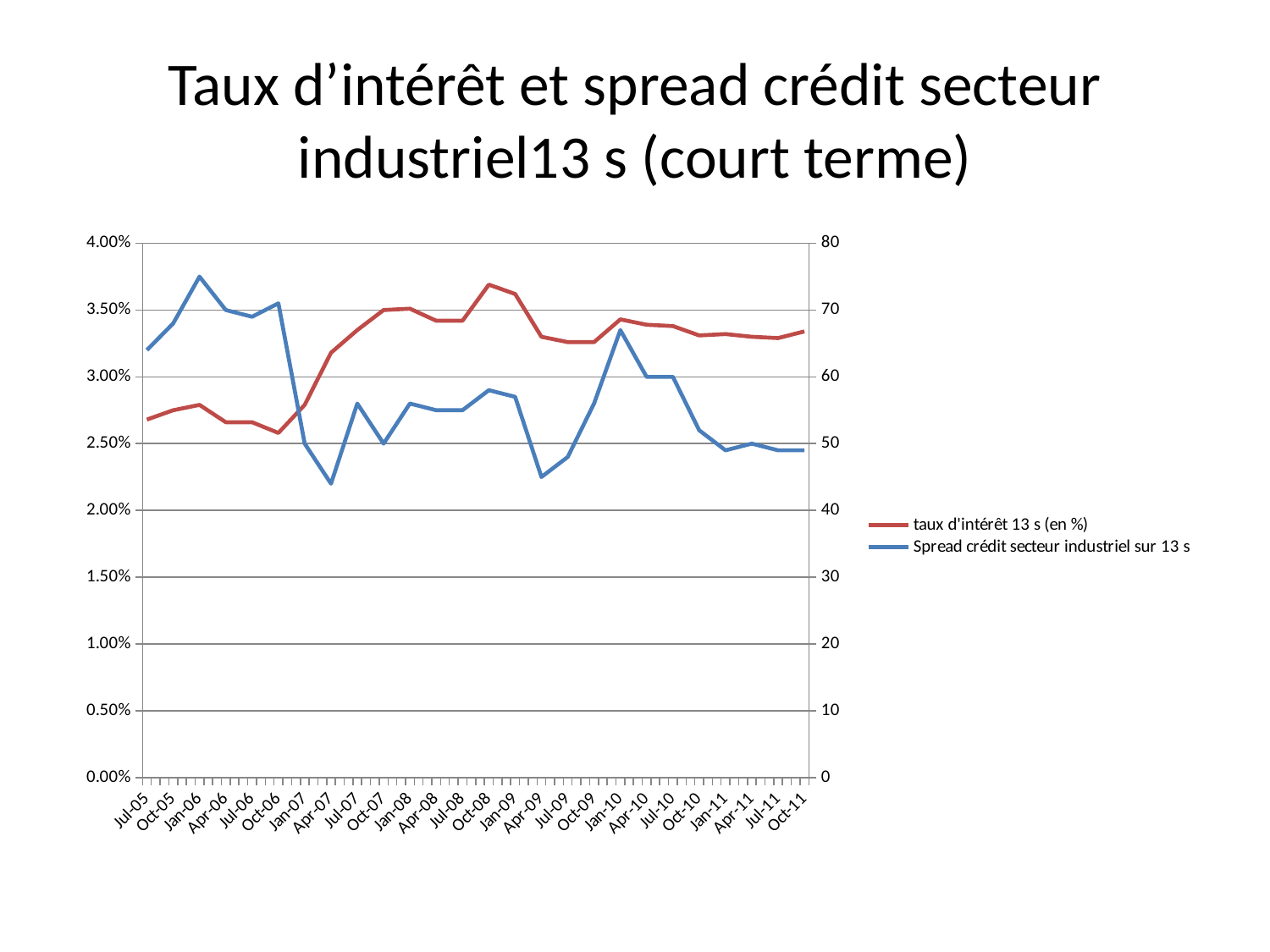
Which is larger for taux d'intérêt 13 s (en %): the value at Jan-08 or the value at Jul-05? Jan-08 Is the value of taux d'intérêt 13 s (en %) at Oct-06 greater or less than 3.00%? less Is the value of Spread crédit secteur industriel sur 13 s at Apr-07 greater or less than 50? less Is the value of Spread crédit secteur industriel sur 13 s at Jan-10 greater or less than 60? greater At which date does the Spread crédit secteur industriel sur 13 s series reach its highest value? Jan-06 At which date does the taux d'intérêt 13 s (en %) series reach its highest value? Oct-08 How many series does the legend list? 2 At which date does the taux d'intérêt 13 s (en %) series reach its lowest value? Oct-06 Does the Spread crédit secteur industriel sur 13 s series rise or fall overall from Jan-10 to Oct-11? fall What kind of chart is shown on the slide? line chart